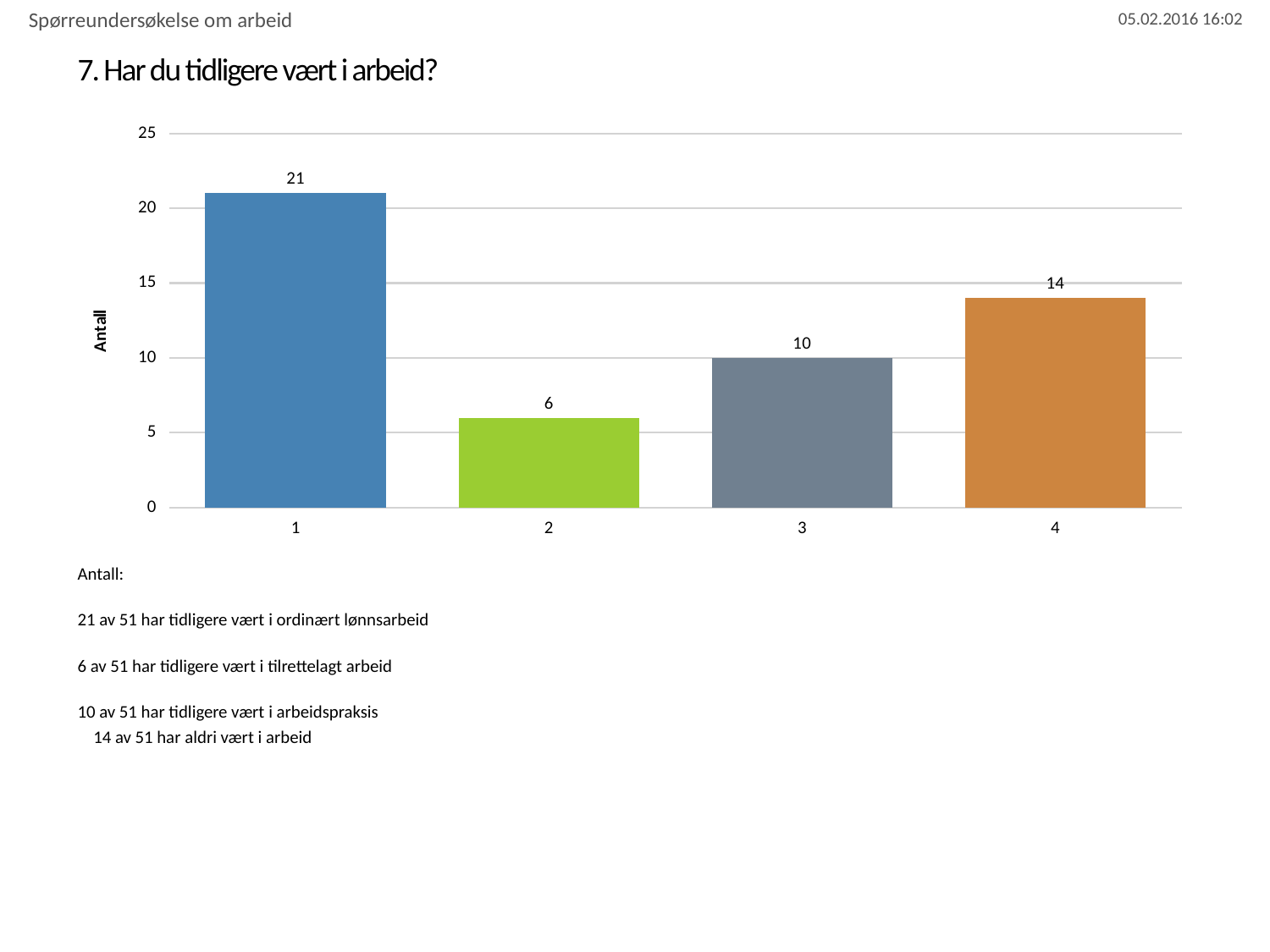
What is the label of the y axis? Antall What is the value for category 1? 21 Which category has the highest value? 1 What kind of chart is this? bar chart Which category has the lowest value? 2 What is the value for category 4? 14 What is the value for category 2? 6 How many categories are shown on the x axis? 4 Which is larger, the value for category 3 or category 4? 4 What is the difference between the values for category 1 and category 4? 7 What is the value for category 3? 10 Is the value for category 3 greater or less than 15? less